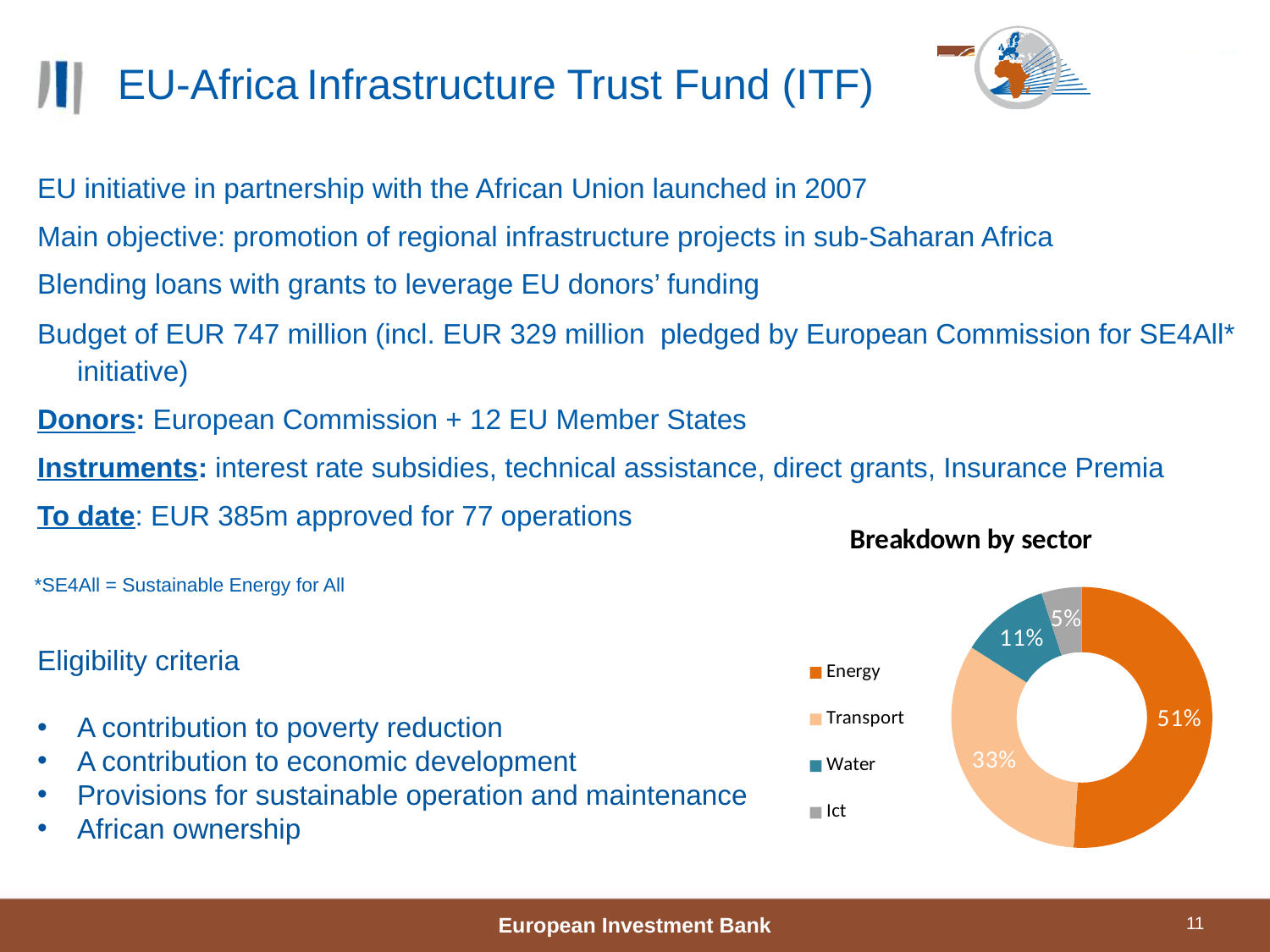
How many sectors are shown in the 'Breakdown by sector' chart? 4 What share of the 'Breakdown by sector' chart does Ict account for? 5% Which sector has the smallest share in the 'Breakdown by sector' chart? Ict In the 'Breakdown by sector' chart, which has a larger share, Water or Ict? Water In the 'Breakdown by sector' chart, what is the difference in percentage points between Energy and Transport? 18 What share of the 'Breakdown by sector' chart does Transport account for? 33% What share of the 'Breakdown by sector' chart does Water account for? 11% What is the title of the chart on the slide? Breakdown by sector What share of the 'Breakdown by sector' chart does Energy account for? 51% Which colour represents Transport in the 'Breakdown by sector' chart? Light orange What type of chart is the 'Breakdown by sector' chart? Pie chart (doughnut) Which sector has the largest share in the 'Breakdown by sector' chart? Energy